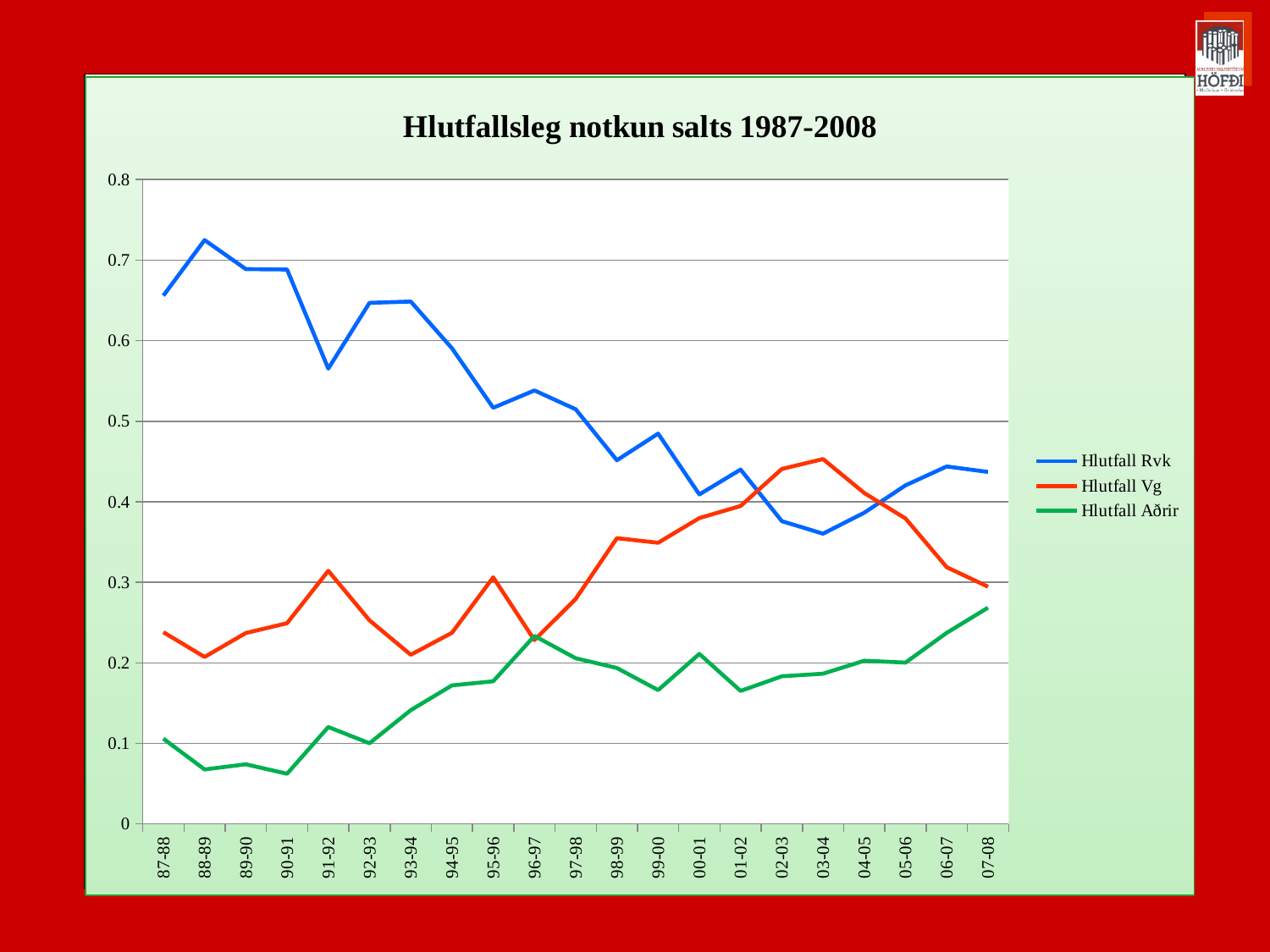
Does the Hlutfall Rvk series generally rise or fall from 87-88 to 07-08? fall Is the value for Hlutfall Rvk in 88-89 greater or less than 0.7? greater What is the title of the chart? Hlutfallsleg notkun salts 1987-2008 Is the value for Hlutfall Aðrir in 90-91 greater or less than 0.1? less How many series does the legend list? 3 How many periods are shown along the x axis? 21 Does the Hlutfall Aðrir series generally rise or fall from 87-88 to 07-08? rise In 03-04, which series has the higher value, Hlutfall Rvk or Hlutfall Vg? Hlutfall Vg In which period does Hlutfall Rvk reach its highest value? 88-89 What kind of chart is shown on the slide? line chart In 87-88, which series has the lowest value? Hlutfall Aðrir